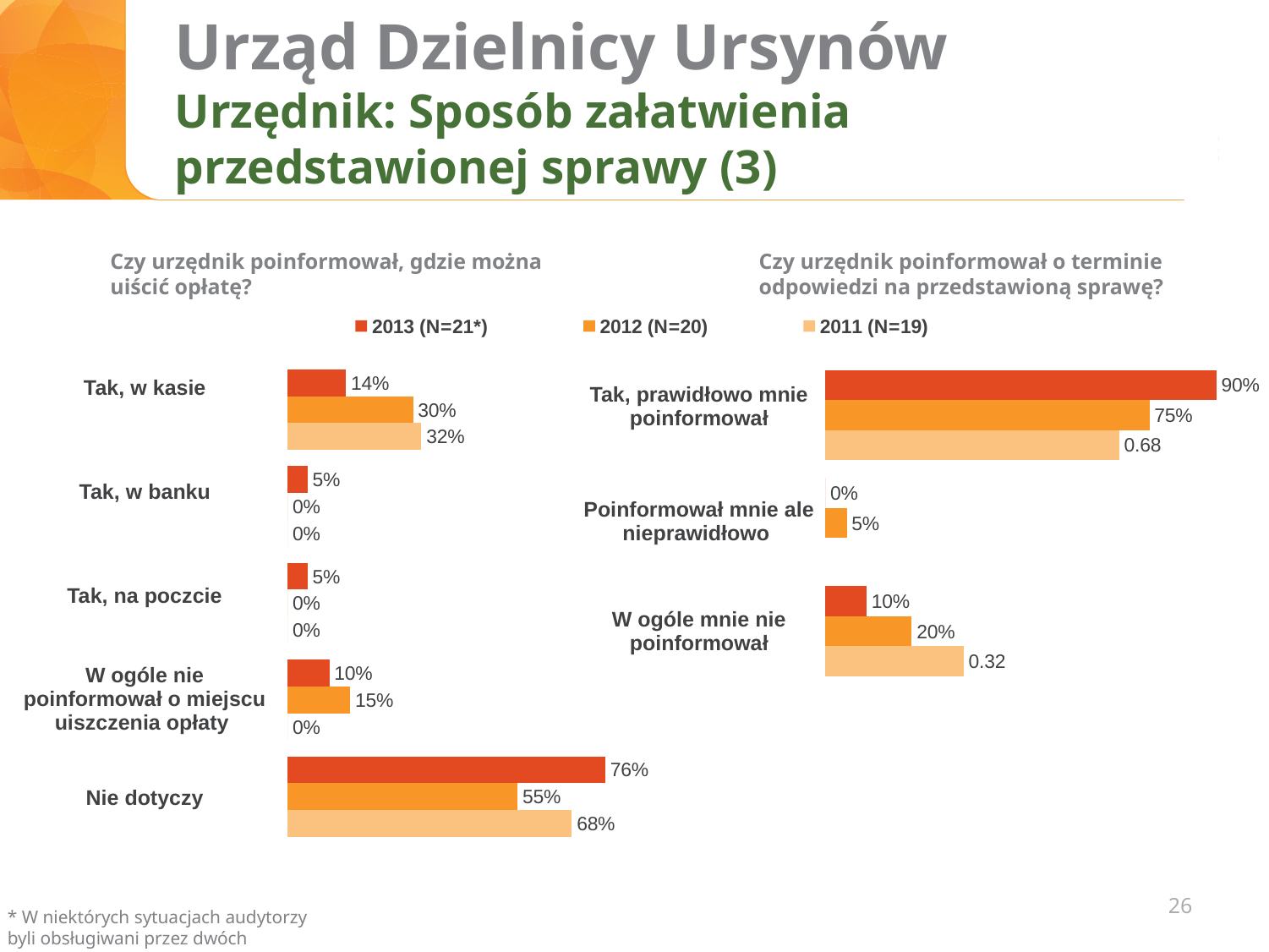
In the right chart ("Czy urzędnik poinformował o terminie odpowiedzi na przedstawioną sprawę?"), what is the difference between the 2013 and 2012 values for "Tak, prawidłowo mnie poinformował"? 15% What type of chart is the right chart ("Czy urzędnik poinformował o terminie odpowiedzi na przedstawioną sprawę?")? Bar chart In the left chart ("Czy urzędnik poinformował, gdzie można uiścić opłatę?"), which category has the highest 2013 value? Nie dotyczy In the right chart ("Czy urzędnik poinformował o terminie odpowiedzi na przedstawioną sprawę?"), what is the 2013 value for "Tak, prawidłowo mnie poinformował"? 90% How many series does the legend list? 3 In the left chart ("Czy urzędnik poinformował, gdzie można uiścić opłatę?"), what is the difference between the 2013 and 2012 values for "Nie dotyczy"? 21% In the left chart ("Czy urzędnik poinformował, gdzie można uiścić opłatę?"), which is larger for "Tak, w kasie": the 2012 value or the 2013 value? 2012 In the left chart ("Czy urzędnik poinformował, gdzie można uiścić opłatę?"), what is the 2011 value for "Tak, w kasie"? 32% How many categories does the left chart ("Czy urzędnik poinformował, gdzie można uiścić opłatę?") show? 5 In the right chart ("Czy urzędnik poinformował o terminie odpowiedzi na przedstawioną sprawę?"), which category has the lowest 2012 value? Poinformował mnie ale nieprawidłowo In the left chart ("Czy urzędnik poinformował, gdzie można uiścić opłatę?"), what is the 2013 value for "Nie dotyczy"? 76% In the right chart ("Czy urzędnik poinformował o terminie odpowiedzi na przedstawioną sprawę?"), what is the 2011 value for "W ogóle mnie nie poinformował"? 0.32